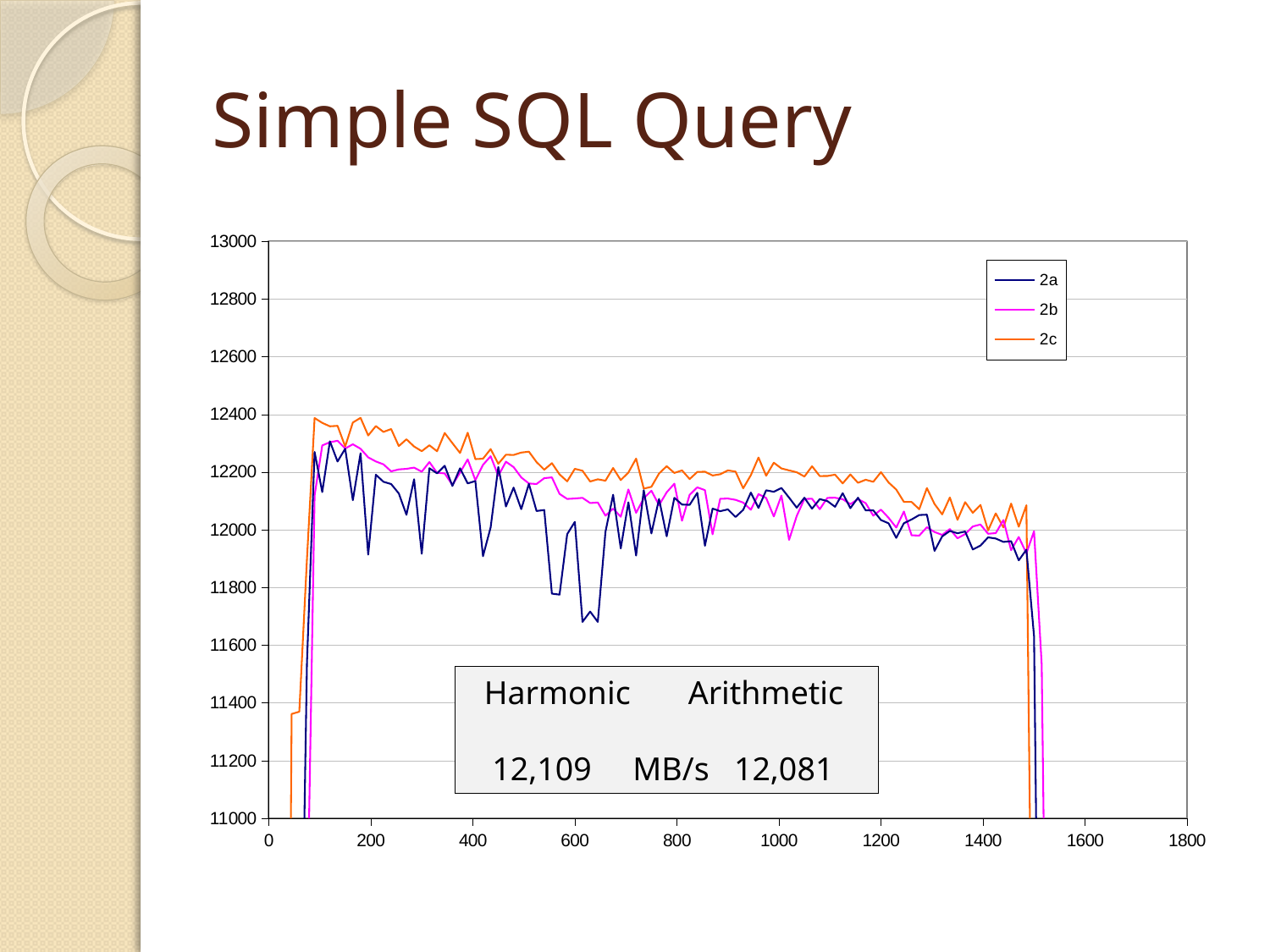
Is the value for 2b at x = 1000 greater or less than 12200? less Is the lowest value of 2a between x = 600 and x = 700 greater or less than 11800? less Is the value for 2c at x = 200 greater or less than 12200? greater Do the values of series 2c generally rise or fall as x increases from 200 to 1400? fall Which series dips to the lowest value between x = 600 and x = 700? 2a What harmonic mean value is printed in the box on the chart? 12,109 MB/s How many series does the legend list? 3 What is the difference between the harmonic value (12,109) and the arithmetic value (12,081) printed on the chart? 28 What are the names of the series listed in the legend? 2a, 2b, 2c Which series has the highest values around x = 200? 2c Which series is plotted in orange? 2c What kind of chart is shown on the slide? line chart